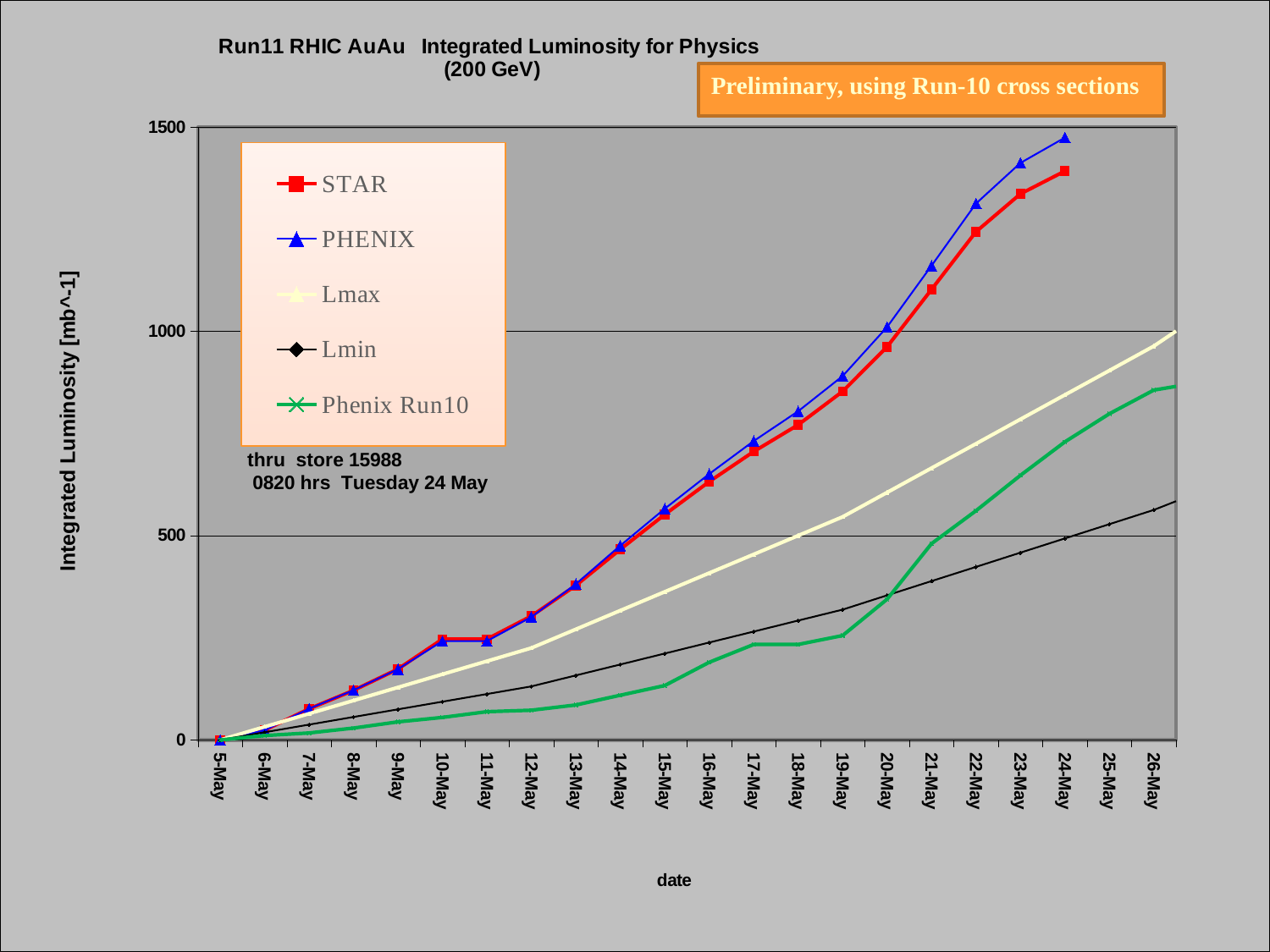
Which series has the highest value on 24-May? PHENIX Is the value for Lmin on 20-May greater or less than 500? less How many dates are labelled along the x axis? 22 Is the value for Phenix Run10 on 26-May greater or less than 1000? less Is the value for Lmin on 26-May greater or less than 500? greater How many series does the legend list? 5 What kind of chart is shown on the slide? line chart Which series has the lowest value on 26-May? Lmin What is the label of the y axis? Integrated Luminosity [mb^-1] What is the title of the chart? Run11 RHIC AuAu Integrated Luminosity for Physics (200 GeV) Does the STAR series rise or fall from 5-May to 24-May? rise